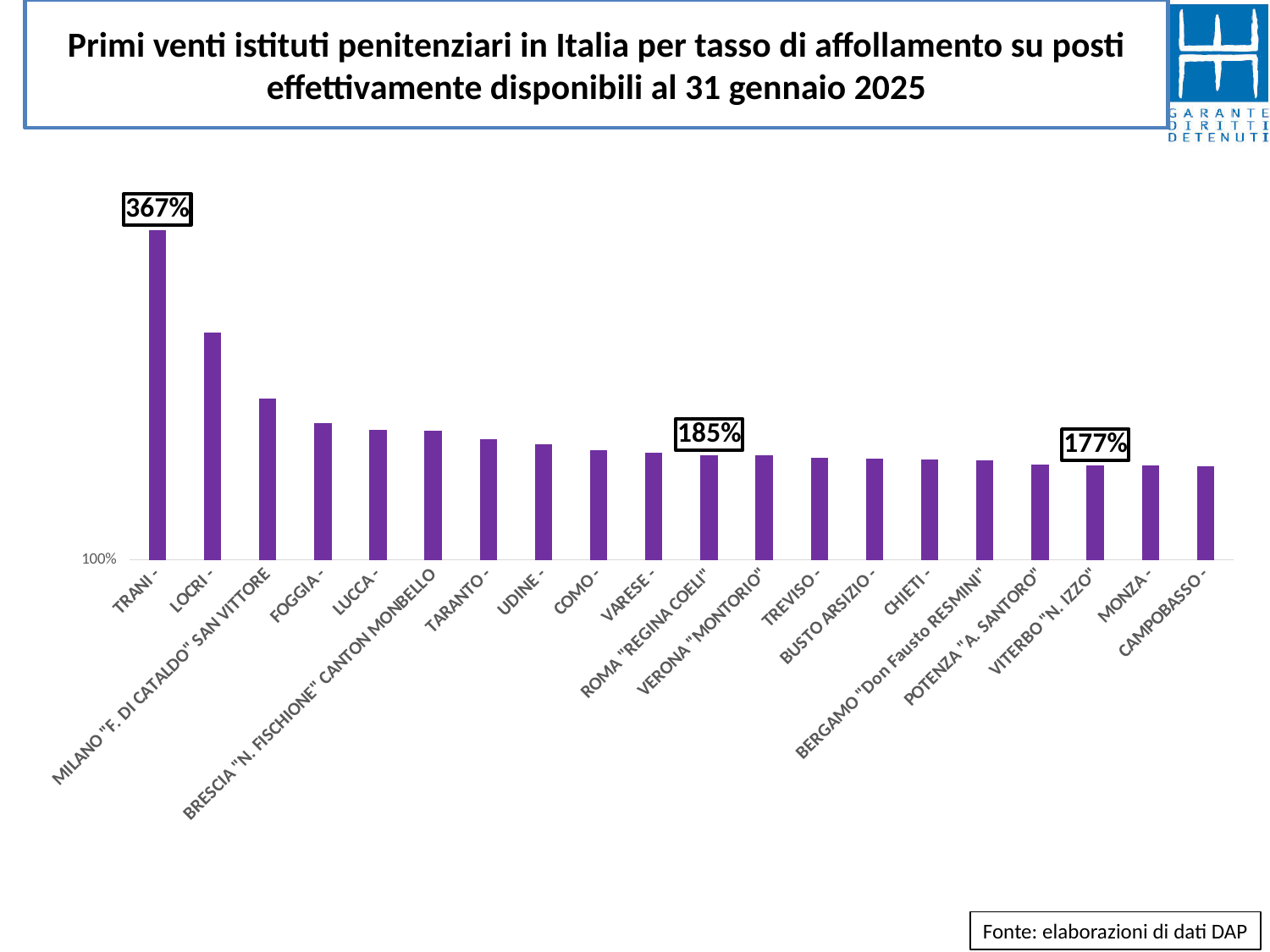
Which institute has the highest value? TRANI How many institutes are shown on the chart? 20 What is the value for VITERBO "N. IZZO"? 177% Which is larger, the value for LOCRI or the value for FOGGIA? LOCRI What is the value for ROMA "REGINA COELI"? 185% What is the difference between the values for ROMA "REGINA COELI" and VITERBO "N. IZZO"? 8 percentage points What is the value for TRANI? 367% What source is cited for the chart data? Fonte: elaborazioni di dati DAP What is the difference between the values for TRANI and ROMA "REGINA COELI"? 182 percentage points Do the values rise or fall from left to right along the x axis? fall What kind of chart is shown on the slide? bar chart Is the value for LOCRI greater or less than 100%? greater